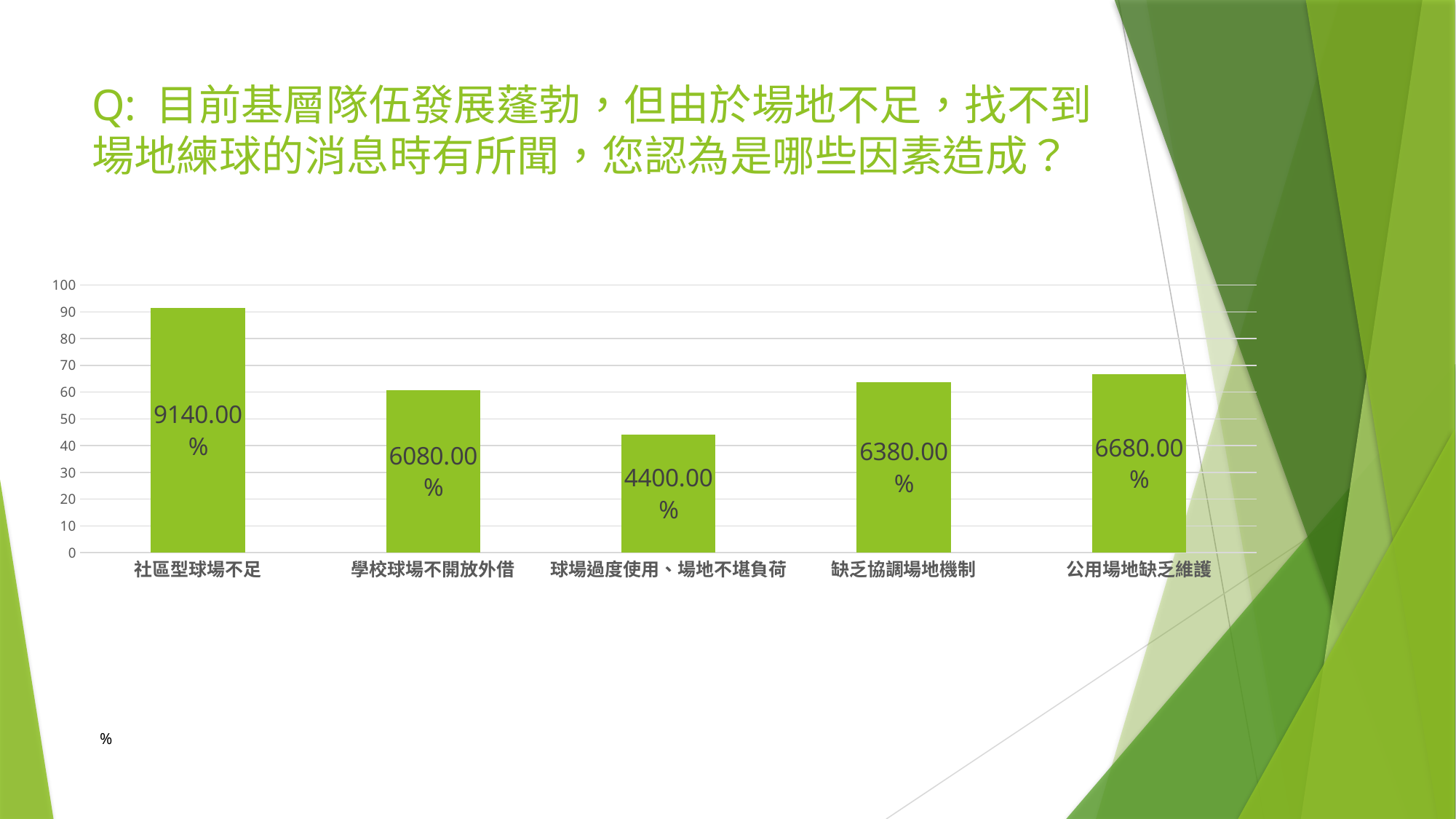
How many categories are shown on the chart? 5 What is the data label shown on the bar for 社區型球場不足? 9140.00% Which is larger, the value for 缺乏協調場地機制 or the value for 公用場地缺乏維護? 公用場地缺乏維護 What kind of chart is shown on the slide? bar chart What is the difference between the data labels for 社區型球場不足 and 學校球場不開放外借? 3060.00% What is the data label shown on the bar for 缺乏協調場地機制? 6380.00% Which category has the lowest bar? 球場過度使用、場地不堪負荷 Is the bar for 球場過度使用、場地不堪負荷 greater or less than 50 on the vertical axis? less Is the bar for 學校球場不開放外借 greater or less than 50 on the vertical axis? greater What is the data label shown on the bar for 公用場地缺乏維護? 6680.00% What is the data label shown on the bar for 球場過度使用、場地不堪負荷? 4400.00% Which category has the highest bar? 社區型球場不足